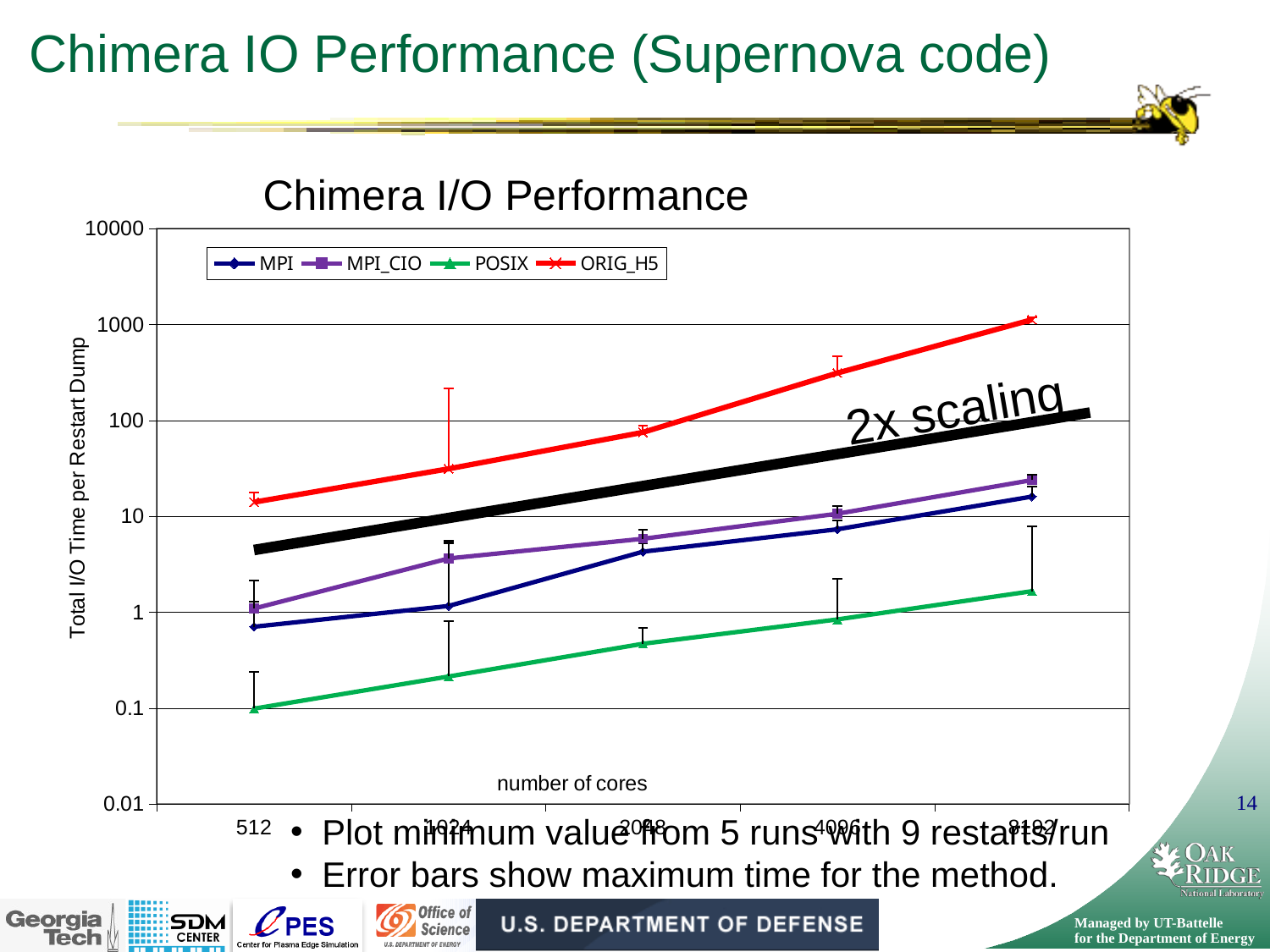
Which series has the highest Total I/O Time per Restart Dump at 8192 cores? ORIG_H5 Does the ORIG_H5 series rise or fall as the number of cores increases? rise How many core counts are plotted along the x axis? 5 Which series has the lowest Total I/O Time per Restart Dump at 512 cores? POSIX What is the title of the y axis? Total I/O Time per Restart Dump What kind of chart is shown on the slide? line chart Is the value for POSIX at 512 cores greater or less than 1? less At 4096 cores, which series has the larger value, MPI_CIO or MPI? MPI_CIO Is the value for MPI at 2048 cores greater or less than 10? less Is the value for ORIG_H5 at 512 cores greater or less than 10? greater How many series does the legend list? 4